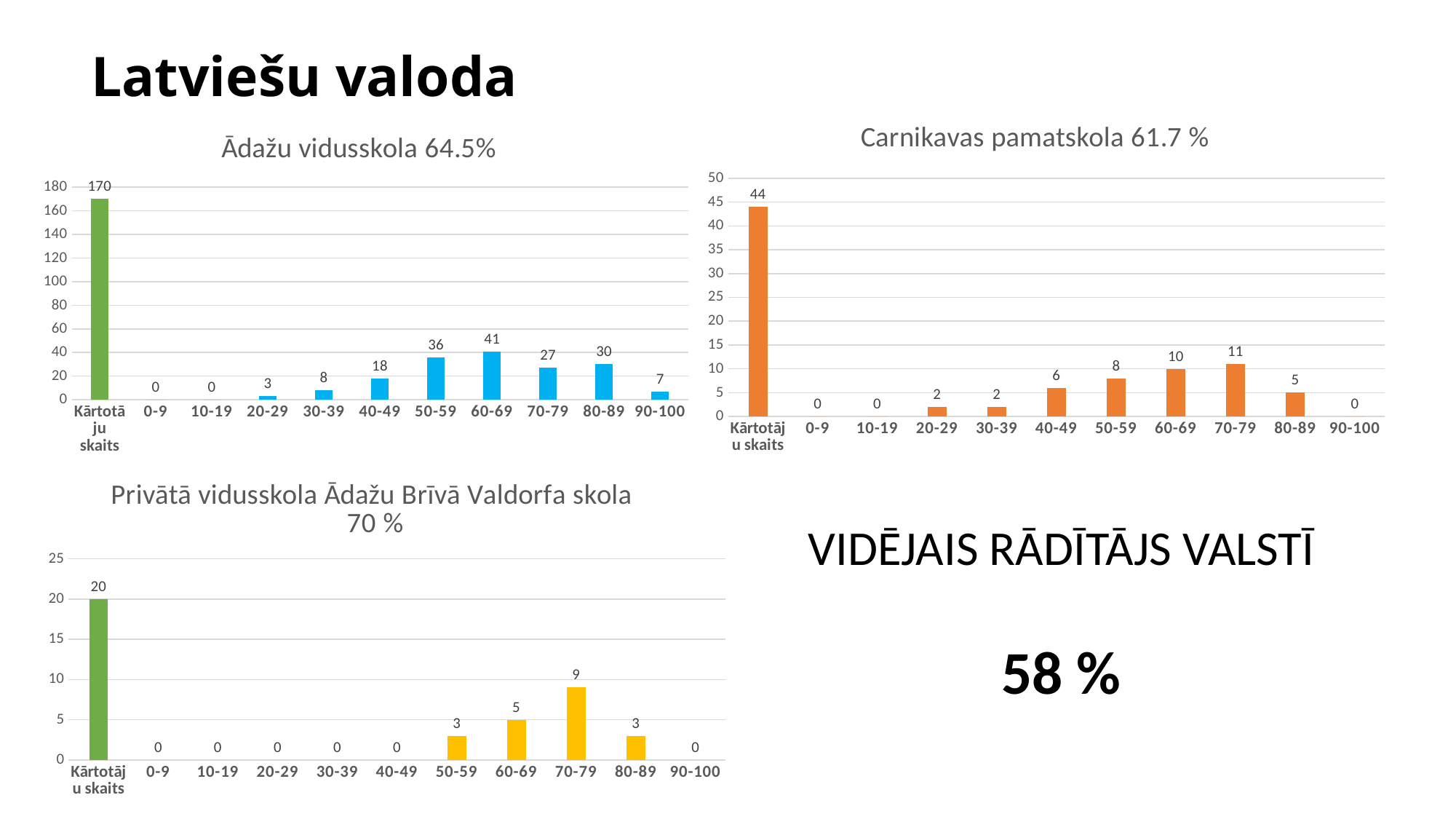
In the 'Ādažu vidusskola 64.5%' chart, what is the value for the 60-69 category? 41 In the 'Carnikavas pamatskola 61.7 %' chart, which is larger, the value for 50-59 or the value for 80-89? 50-59 How many categories are shown on the x axis of the 'Ādažu vidusskola 64.5%' chart? 11 In the 'Privātā vidusskola Ādažu Brīvā Valdorfa skola 70 %' chart, what is the value for the 70-79 category? 9 In the 'Ādažu vidusskola 64.5%' chart, is the value for 'Kārtotāju skaits' greater or less than 160? greater What type of chart is the 'Carnikavas pamatskola 61.7 %' chart? Bar chart In the 'Ādažu vidusskola 64.5%' chart, what is the difference between the values for 60-69 and 50-59? 5 What colour are the score-range bars in the 'Privātā vidusskola Ādažu Brīvā Valdorfa skola 70 %' chart? Yellow In the 'Ādažu vidusskola 64.5%' chart, what is the value for 'Kārtotāju skaits'? 170 In the 'Privātā vidusskola Ādažu Brīvā Valdorfa skola 70 %' chart, what is the total of the values for 50-59, 60-69, 70-79 and 80-89? 20 In the 'Carnikavas pamatskola 61.7 %' chart, what is the value for the 70-79 category? 11 In the 'Carnikavas pamatskola 61.7 %' chart, which score range (excluding 'Kārtotāju skaits') has the highest value? 70-79